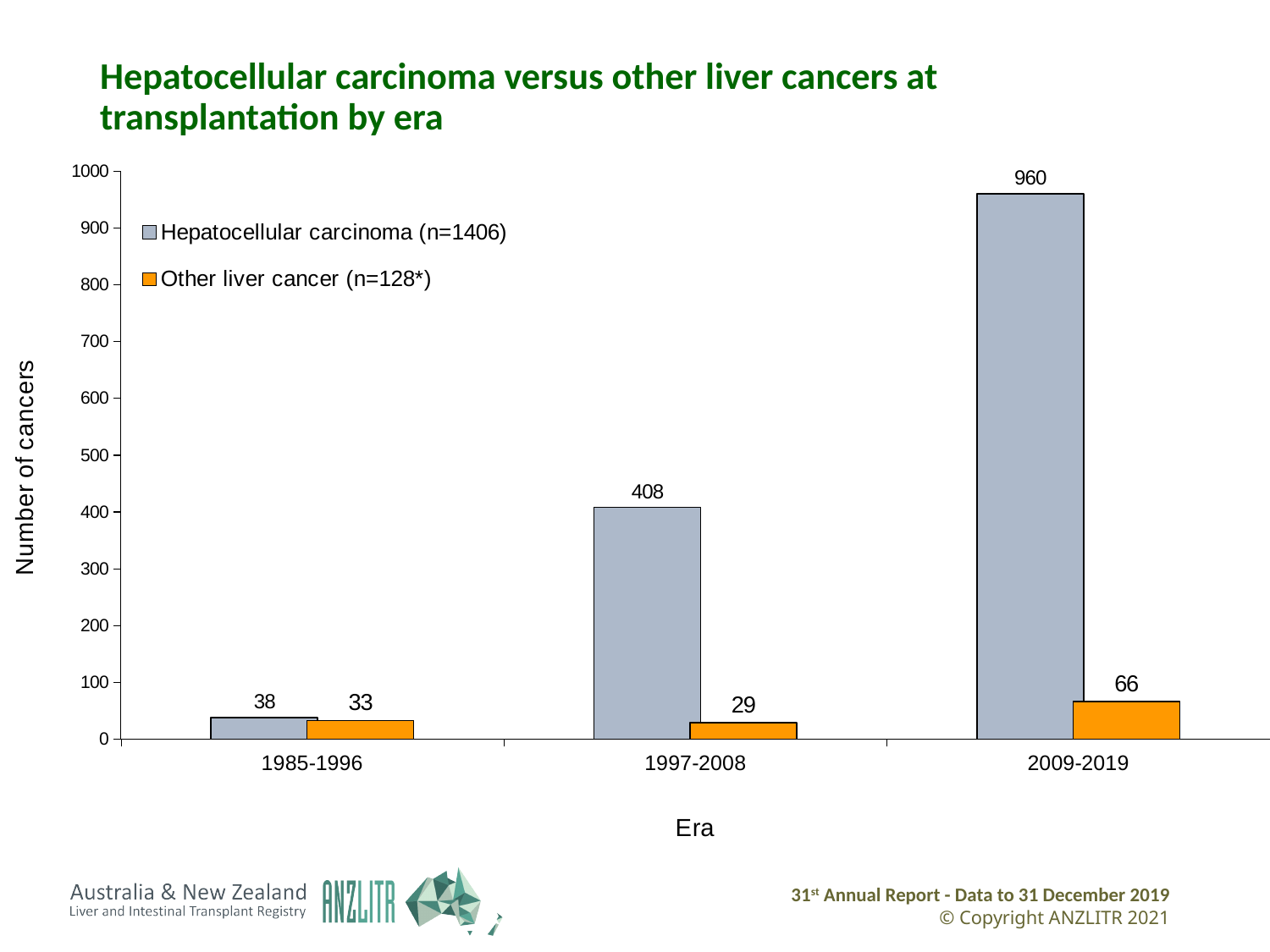
How many series does the legend list? 2 What kind of chart is shown on the slide? Bar chart Which era has the lowest number of other liver cancers? 1997-2008 Which is larger in the 2009-2019 era: hepatocellular carcinoma or other liver cancer? Hepatocellular carcinoma Is the number of hepatocellular carcinoma cancers in 1997-2008 greater or less than 400? greater Do the hepatocellular carcinoma values rise or fall across the eras from 1985-1996 to 2009-2019? Rise Which era has the highest number of hepatocellular carcinoma cancers? 2009-2019 What is the difference between hepatocellular carcinoma and other liver cancer counts in the 1997-2008 era? 379 What is the number of other liver cancers in the 1997-2008 era? 29 What is the number of hepatocellular carcinoma cancers in the 2009-2019 era? 960 What is the number of hepatocellular carcinoma cancers in the 1985-1996 era? 38 How many eras are shown on the x axis? 3